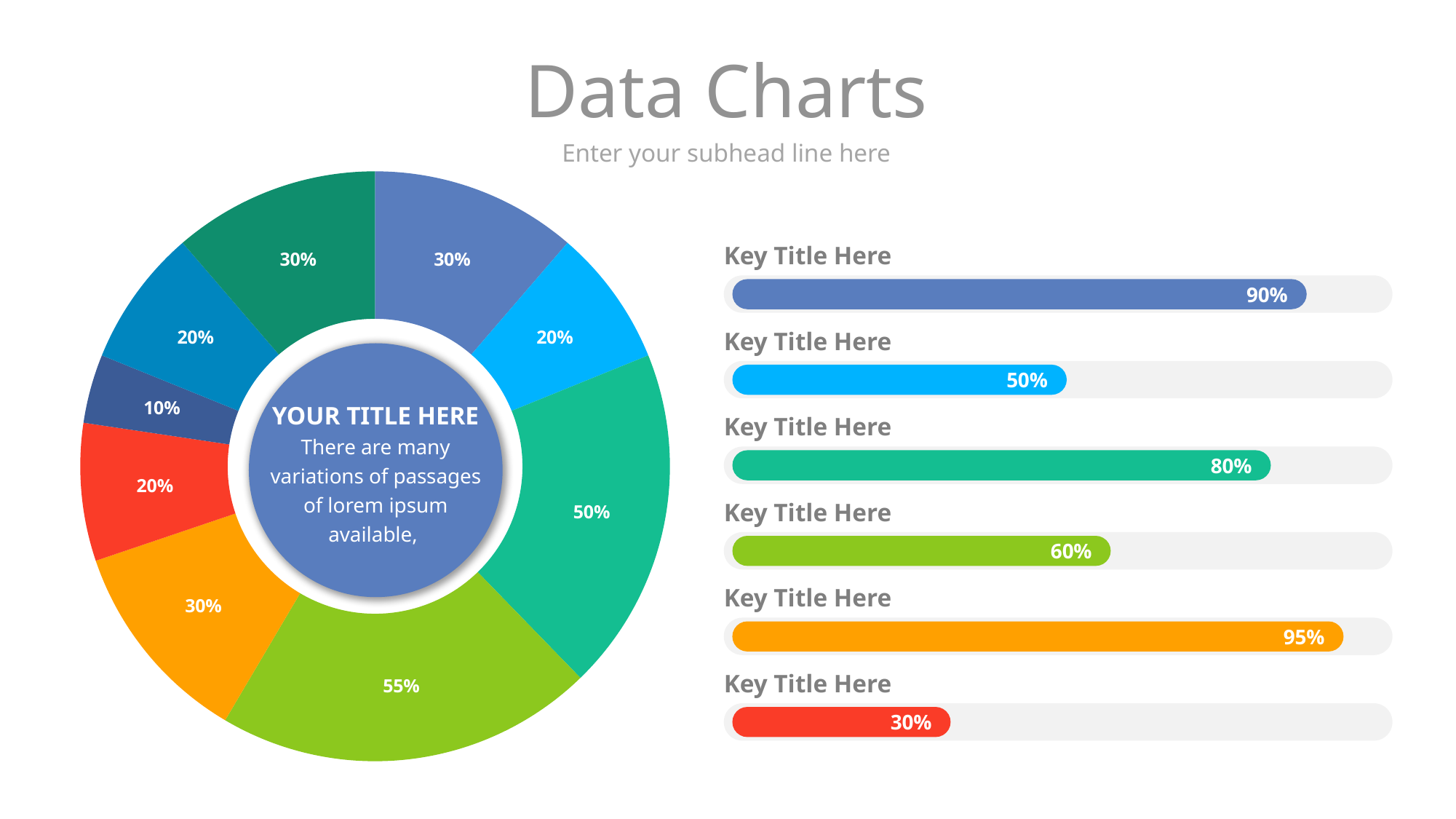
On the bar chart on the right, which bar has the lowest value? The red bar (bottom), 30% How many slices does the pie chart on the left have? 9 On the bar chart on the right, what value is shown on the first (top) bar? 90% On the bar chart on the right, which bar has the highest value? The orange bar (fifth from top), 95% On the pie chart on the left, what is the value of the smallest slice? 10% On the bar chart on the right, what is the difference between the first bar (90%) and the second bar (50%)? 40% On the bar chart on the right, what value is shown on the red bar at the bottom? 30% How many bars are shown on the bar chart on the right? 6 On the bar chart on the right, what value is shown on the orange bar? 95% What kind of chart is on the left side of the slide? Doughnut chart On the pie chart on the left, what is the value of the largest slice? 55% On the bar chart on the right, which is larger: the green bar or the light-green bar? The green bar (80%)